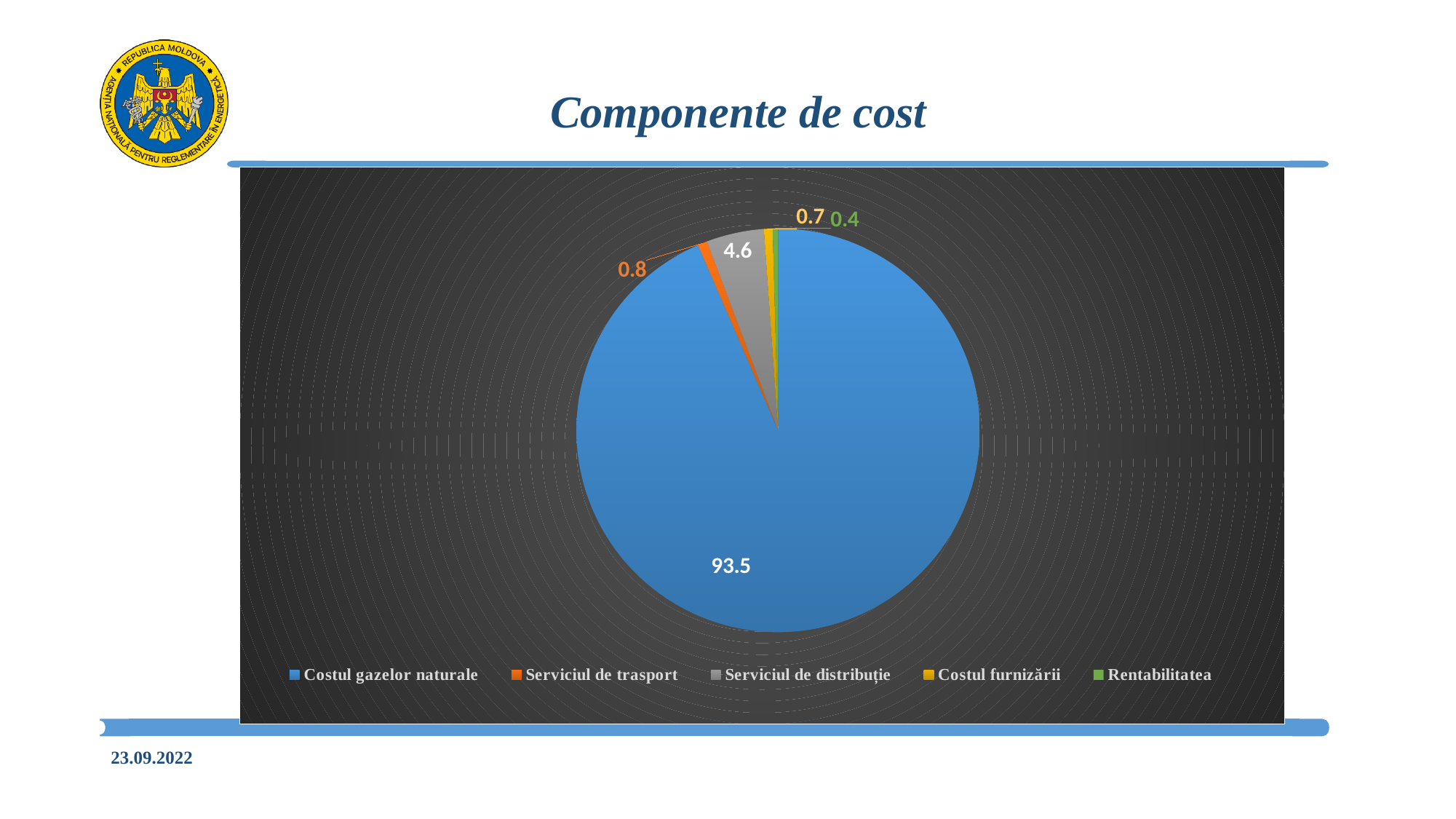
Which component has the smallest slice of the pie? Rentabilitatea What type of chart is shown on the slide? pie chart What is the value for Costul gazelor naturale? 93.5 How many slices does the pie chart have? 5 What is the title of the chart? Componente de cost Which legend entry is shown in orange? Serviciul de trasport What is the value for Rentabilitatea? 0.4 Which is larger, the value for Costul furnizării or the value for Rentabilitatea? Costul furnizării What is the difference between the values for Costul gazelor naturale and Serviciul de distribuție? 88.9 What is the value for Serviciul de distribuție? 4.6 What is the value for Serviciul de trasport? 0.8 Which component has the largest slice of the pie? Costul gazelor naturale